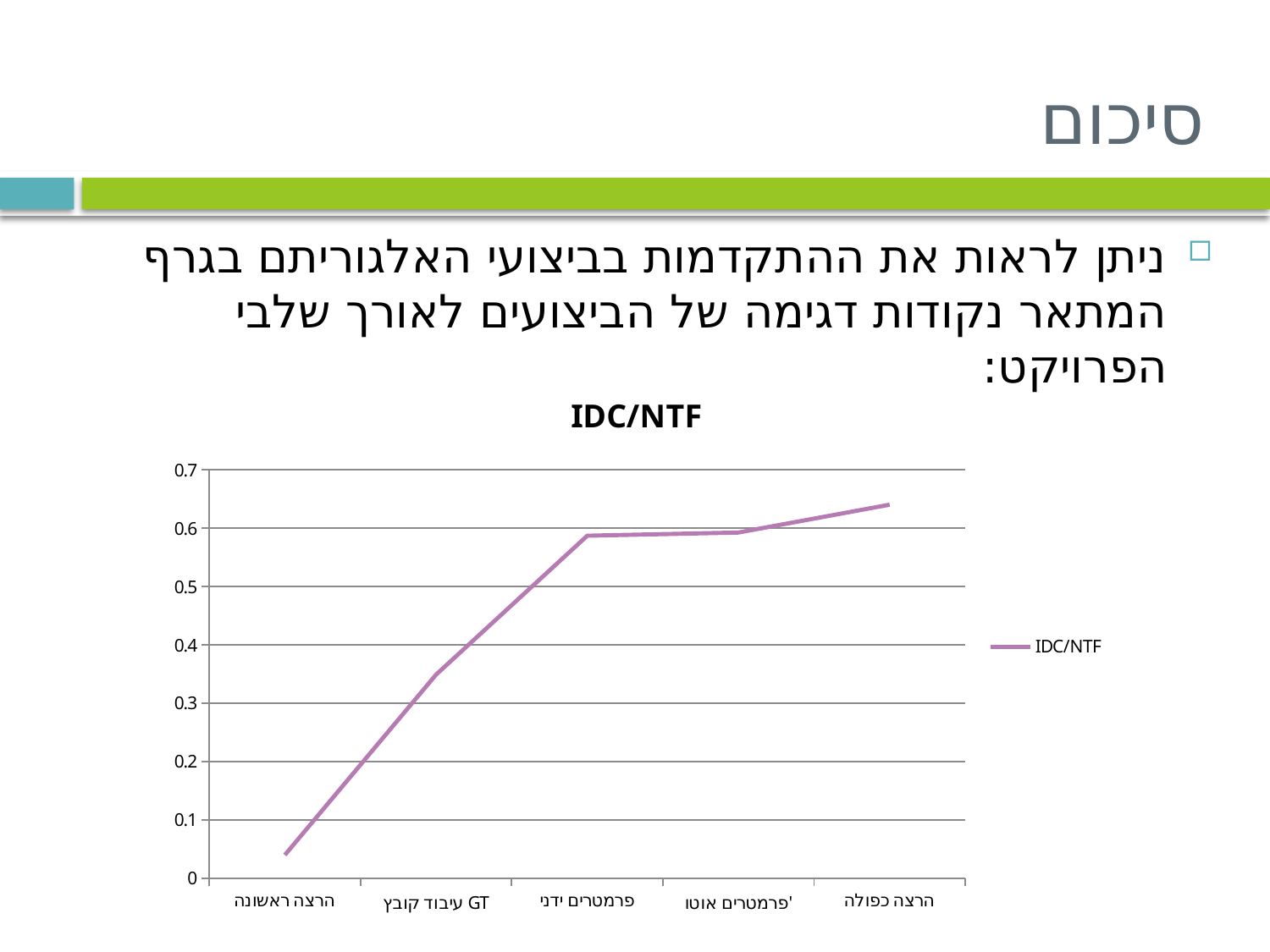
Is the IDC/NTF value for הרצה כפולה greater or less than 0.6? greater Which category has the lowest IDC/NTF value? הרצה ראשונה Which has a larger IDC/NTF value, עיבוד קובץ GT or פרמטרים ידני? פרמטרים ידני Is the IDC/NTF value for הרצה ראשונה greater or less than 0.1? less Do the IDC/NTF values rise or fall from left to right along the x axis? rise What kind of chart is shown on the slide? line chart Is the IDC/NTF value for עיבוד קובץ GT greater or less than 0.3? greater What is the title of the chart? IDC/NTF Which category has the highest IDC/NTF value? הרצה כפולה How many series does the chart's legend list? 1 What is the name of the series shown in the chart's legend? IDC/NTF How many categories are shown on the x axis of the chart? 5